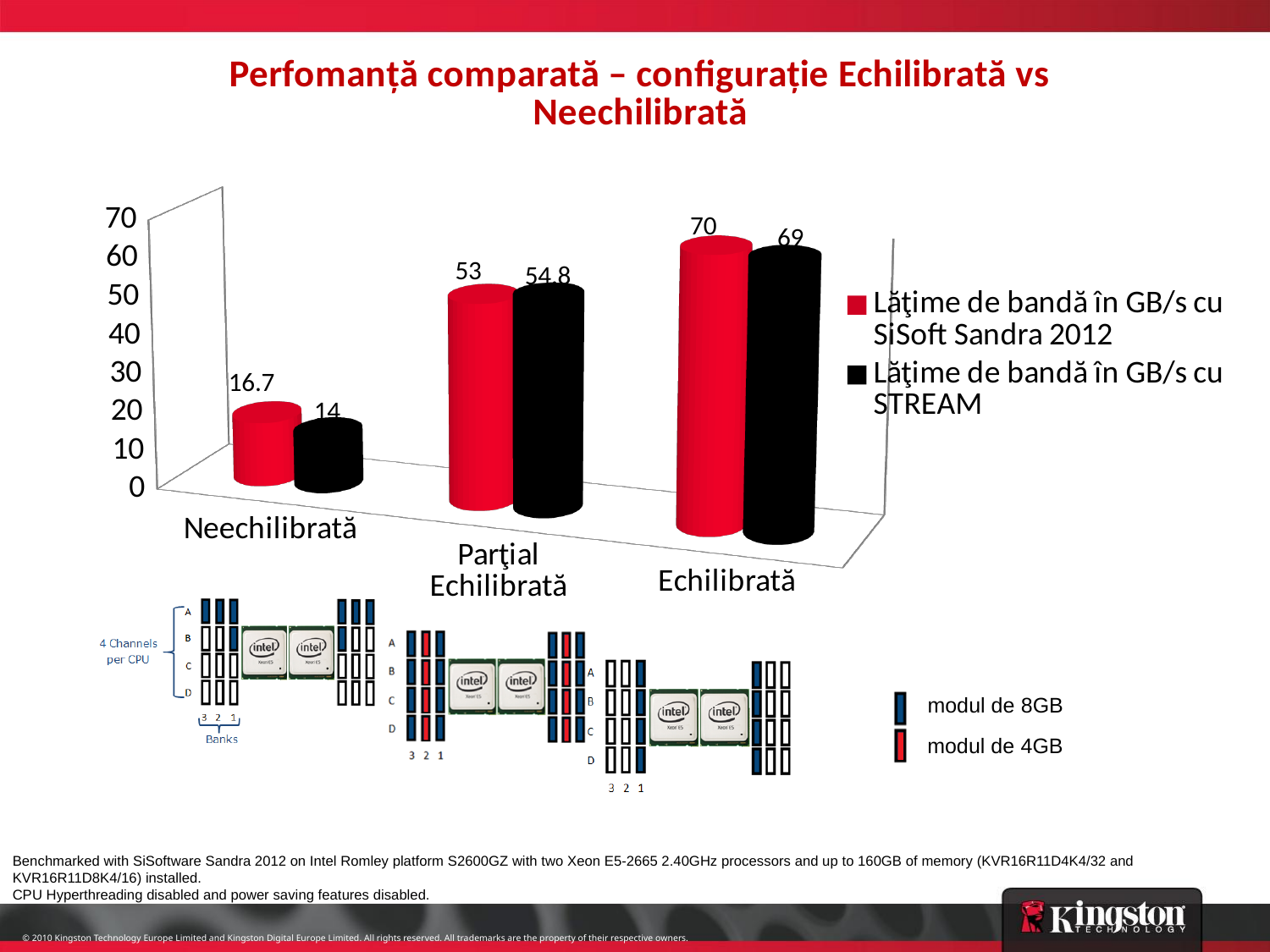
How many series does the chart legend list? 2 Which category has the lowest value in the SiSoft Sandra 2012 series? Neechilibrată How many categories are shown on the x axis of the chart? 3 For Parţial Echilibrată, which series has the larger value: SiSoft Sandra 2012 or STREAM? STREAM Which category has the highest value in the STREAM series? Echilibrată What is the value for Echilibrată in the SiSoft Sandra 2012 series? 70 Is the STREAM value for Neechilibrată greater or less than 20? less What is the value for Parţial Echilibrată in the STREAM series? 54.8 What is the difference between the SiSoft Sandra 2012 values for Echilibrată and Neechilibrată? 53.3 Do the SiSoft Sandra 2012 values rise or fall from Neechilibrată to Echilibrată? rise What is the value for Neechilibrată in the SiSoft Sandra 2012 series? 16.7 What kind of chart is shown on the slide? bar chart